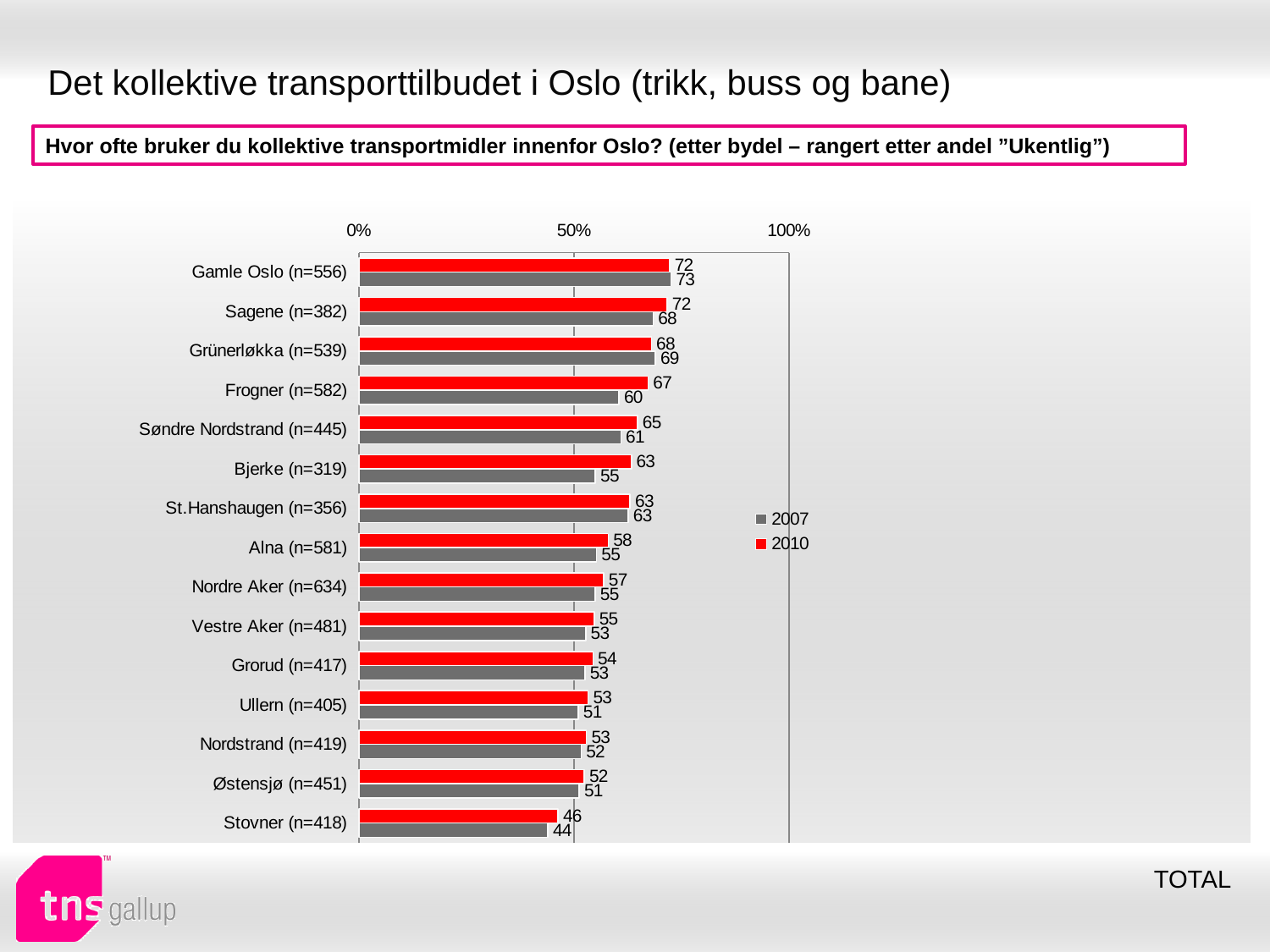
What is the 2007 value for Bjerke (n=319)? 55 Which district has the highest 2007 value? Gamle Oslo (n=556) What type of chart is shown on the slide? bar chart How many series does the legend list? 2 How many districts are shown in the chart? 15 What is the difference between the 2010 and 2007 values for Bjerke (n=319)? 8 For Grünerløkka (n=539), which is larger: the 2007 value or the 2010 value? 2007 What is the difference between the 2010 and 2007 values for Frogner (n=582)? 7 What is the 2010 value for Frogner (n=582)? 67 What is the 2010 value for Stovner (n=418)? 46 Which district has the lowest 2010 value? Stovner (n=418) Is the 2007 value for Stovner (n=418) greater or less than 50%? less